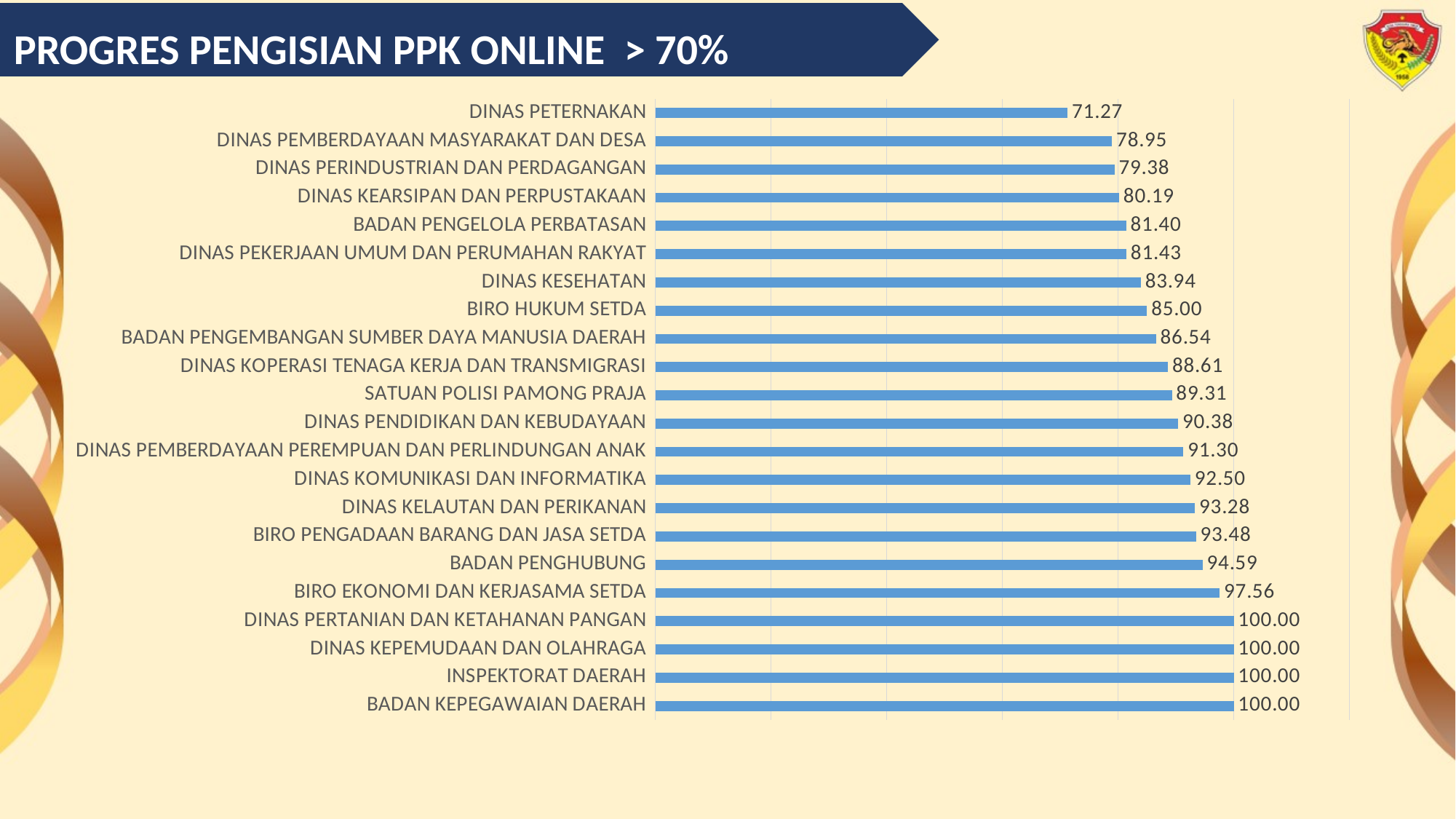
What is the value for DINAS PETERNAKAN? 71.27 What is the difference between the values for BIRO HUKUM SETDA and DINAS PETERNAKAN? 13.73 What kind of chart is shown on the slide? Bar chart What is the title of the slide? PROGRES PENGISIAN PPK ONLINE > 70% What is the difference between the values for BADAN PENGHUBUNG and DINAS KOMUNIKASI DAN INFORMATIKA? 2.09 Which is larger, the value for DINAS KELAUTAN DAN PERIKANAN or the value for DINAS PENDIDIKAN DAN KEBUDAYAAN? DINAS KELAUTAN DAN PERIKANAN How many categories are shown in the chart? 22 What is the value for DINAS KESEHATAN? 83.94 What is the value for BIRO EKONOMI DAN KERJASAMA SETDA? 97.56 Which category has the lowest value? DINAS PETERNAKAN What is the value for SATUAN POLISI PAMONG PRAJA? 89.31 How many categories have a value of 100.00? 4